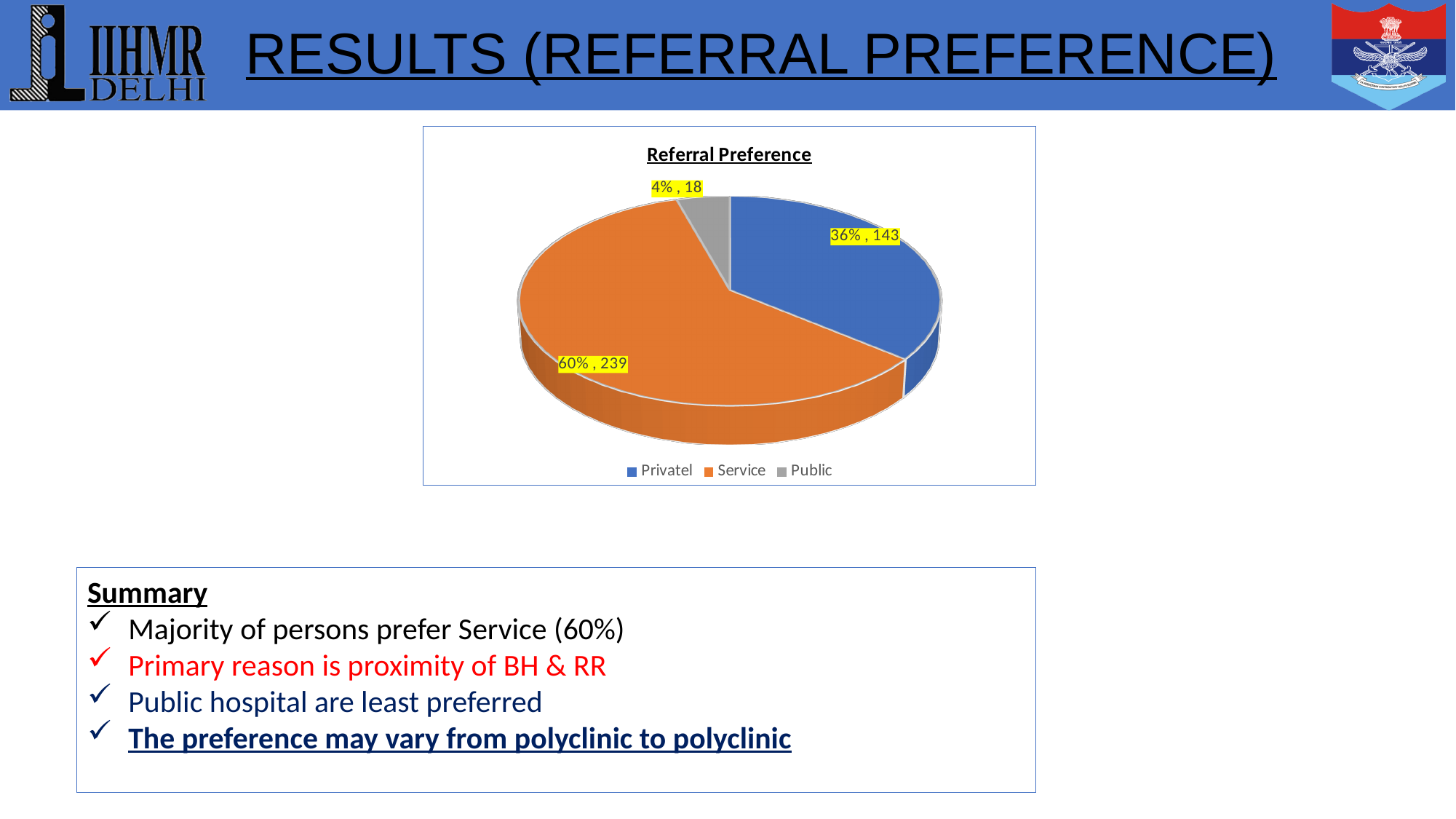
What is the title of the chart? Referral Preference How many slices does the pie chart have? 3 Which category has the largest slice? Service What is the count for Public? 18 What is the count for Service? 239 What share of the pie does Public represent? 4% What kind of chart is shown on the slide? Pie chart What share of the pie does Service represent? 60% What is the difference between the counts for Service and Privatel? 96 How many entries does the legend list? 3 What is the count for Privatel? 143 Which category has the smallest slice? Public